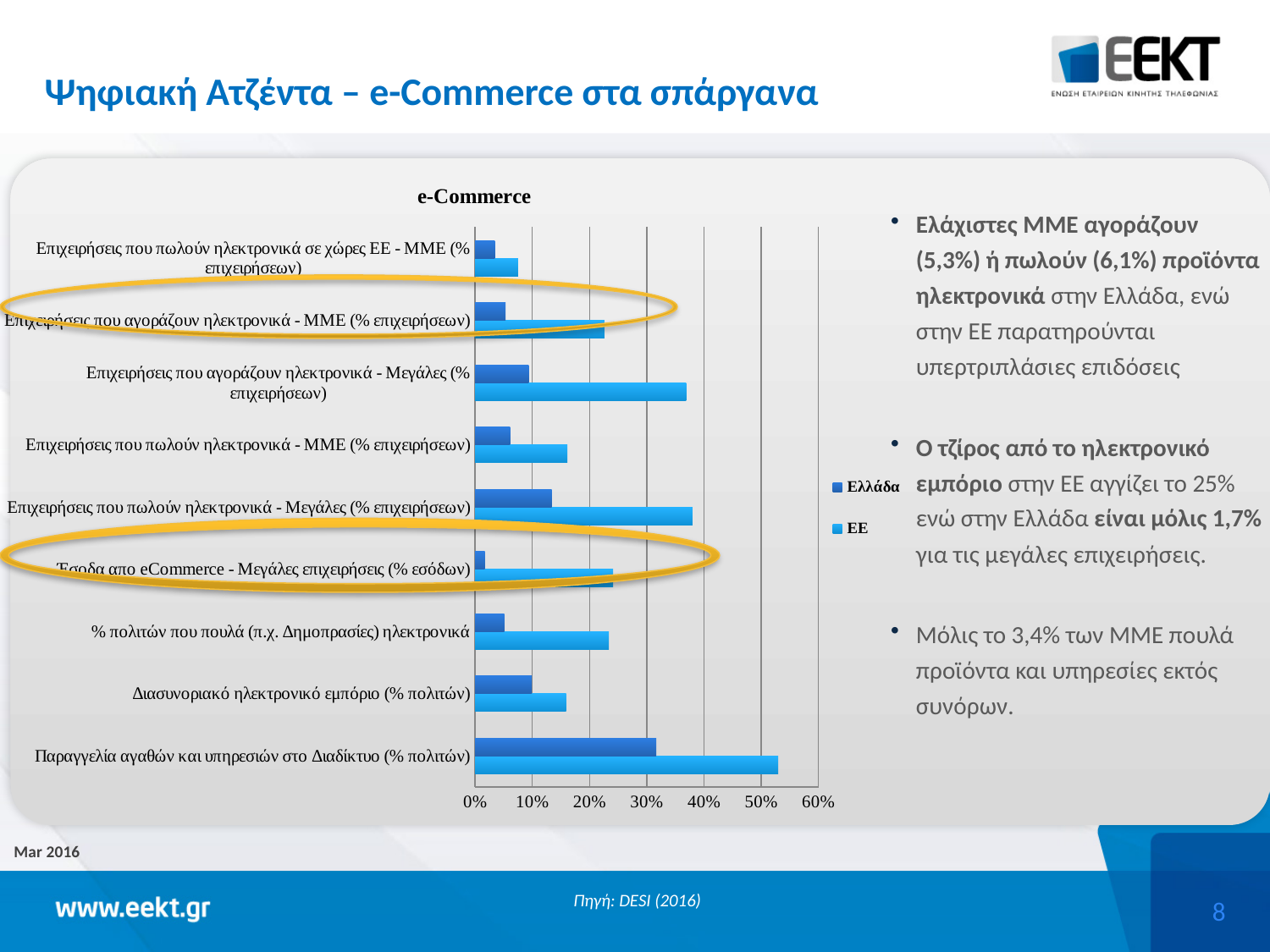
Which category has the highest value for the ΕΕ series? Παραγγελία αγαθών και υπηρεσιών στο Διαδίκτυο (% πολιτών) Which category has the highest value for the Ελλάδα series? Παραγγελία αγαθών και υπηρεσιών στο Διαδίκτυο (% πολιτών) How many categories are plotted on the chart? 9 Is the Ελλάδα value for Επιχειρήσεις που πωλούν ηλεκτρονικά - Μεγάλες (% επιχειρήσεων) greater or less than 20%? less Which two series are listed in the chart legend? Ελλάδα and ΕΕ For Έσοδα απο eCommerce - Μεγάλες επιχειρήσεις (% εσόδων), which series has the larger value, Ελλάδα or ΕΕ? ΕΕ Is the ΕΕ value for Παραγγελία αγαθών και υπηρεσιών στο Διαδίκτυο (% πολιτών) greater or less than 50%? greater Which category has the lowest value for the Ελλάδα series? Έσοδα απο eCommerce - Μεγάλες επιχειρήσεις (% εσόδων) What kind of chart is shown on the slide? Bar chart How many series does the chart legend list? 2 What is the title of the chart? e-Commerce Is the ΕΕ value for Επιχειρήσεις που αγοράζουν ηλεκτρονικά - Μεγάλες (% επιχειρήσεων) greater or less than 30%? greater